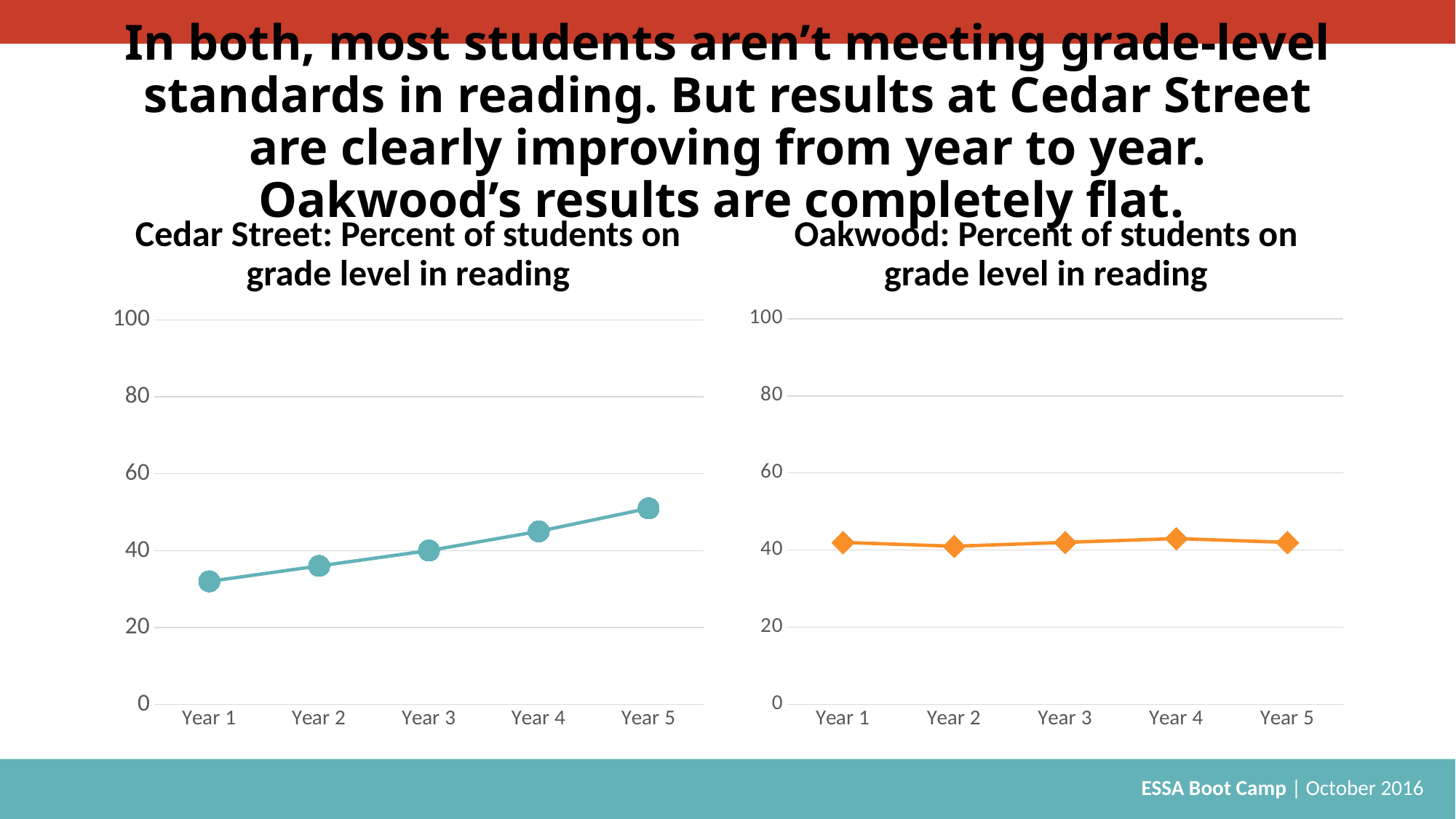
On the Cedar Street chart, is the value for Year 5 greater or less than 40? greater On the Cedar Street chart, which year has the highest value? Year 5 What kind of chart is the Cedar Street chart? line chart What is the title of the chart on the right side of the slide? Oakwood: Percent of students on grade level in reading On the Cedar Street chart, which year has the lowest value? Year 1 On the Oakwood chart, is the value for Year 3 greater or less than 60? less On the Cedar Street chart, is the value for Year 1 greater or less than 40? less On the Cedar Street chart, do the values rise or fall from Year 1 to Year 5? rise How many data points are plotted on the Oakwood chart? 5 How many years are plotted on the Cedar Street chart? 5 What kind of chart is the Oakwood chart? line chart Which is larger: the Year 5 value on the Cedar Street chart or the Year 5 value on the Oakwood chart? Cedar Street